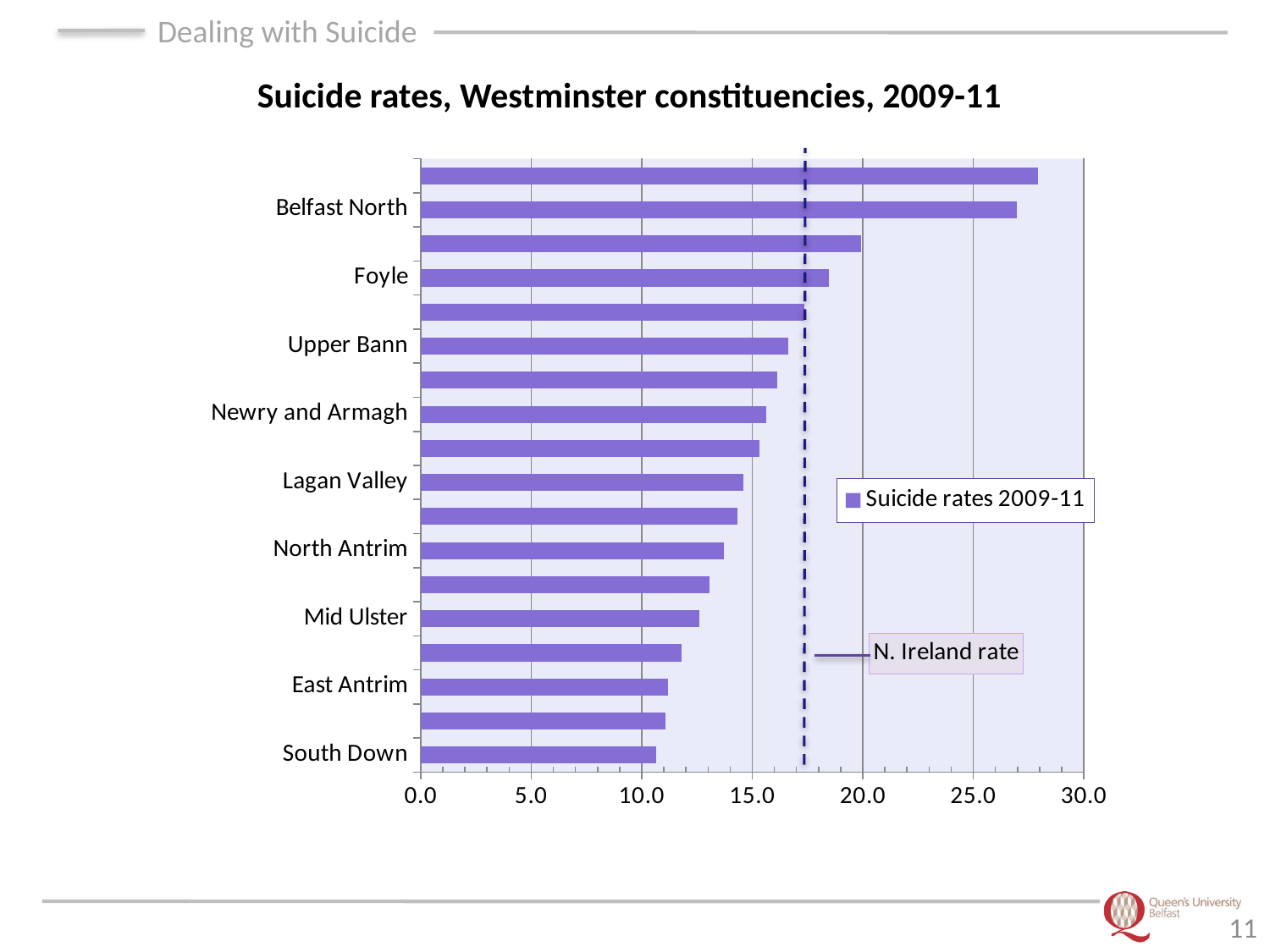
How many series does the legend list? 1 Is the value for Belfast North greater or less than 25.0? greater Is the value for Foyle greater or less than 15.0? greater Which has the larger value, Foyle or Mid Ulster? Foyle What does the dashed vertical line on the chart represent? N. Ireland rate Is the value for Mid Ulster greater or less than 15.0? less Which category has the lowest value on the chart? South Down Which has the larger value, Belfast North or South Down? Belfast North What is the title of the chart? Suicide rates, Westminster constituencies, 2009-11 What kind of chart is shown on the slide? bar chart